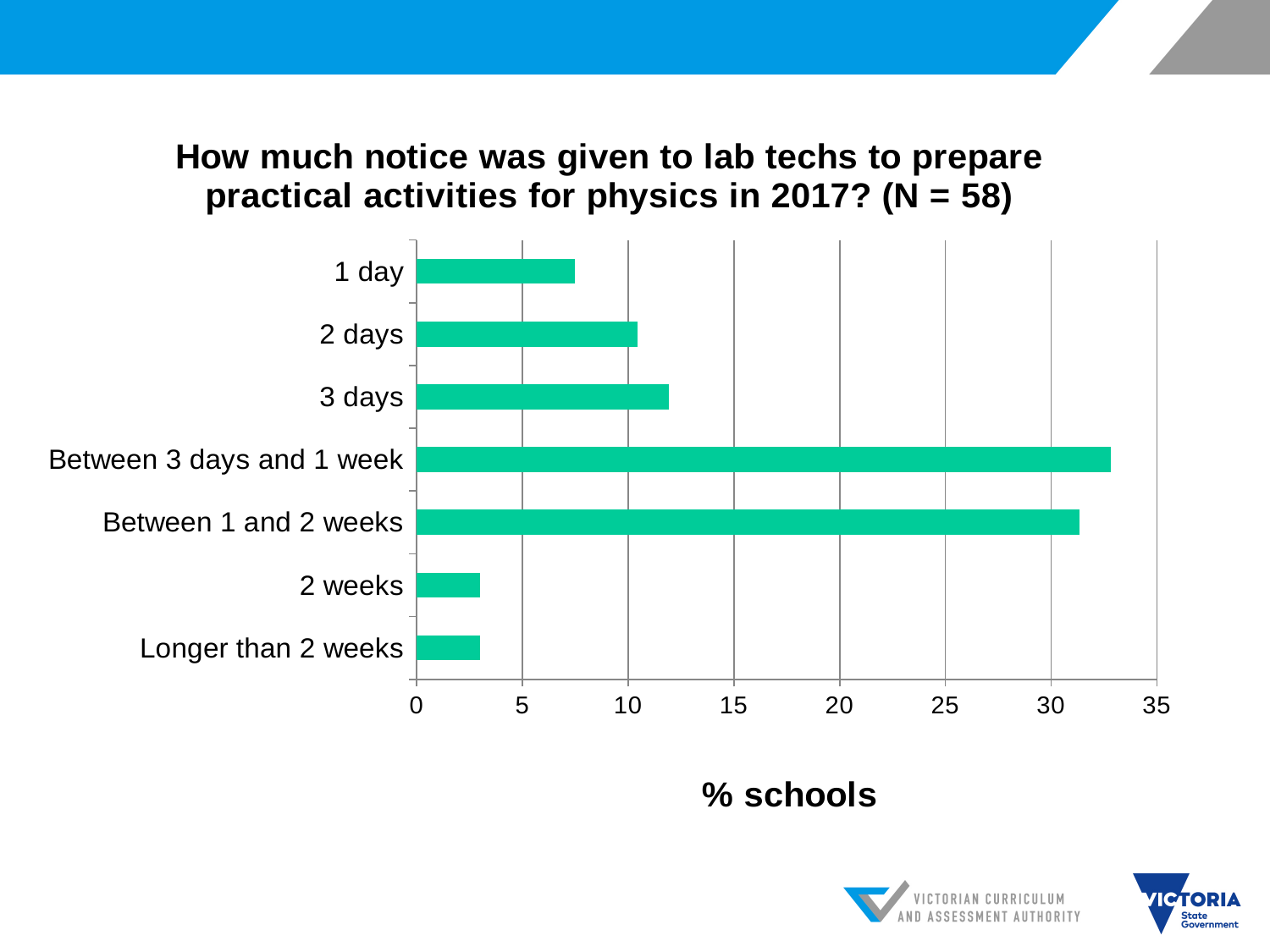
Is the value for Between 3 days and 1 week greater or less than 30? greater Is the value for Between 1 and 2 weeks greater or less than 30? greater What kind of chart is shown on the slide? bar chart What is the label on the horizontal axis of the chart? % schools What is the highest tick value shown on the horizontal axis? 35 Which is larger, the value for 1 day or the value for 2 days? 2 days Is the value for 2 weeks greater or less than 5? less How many categories are shown on the chart? 7 Which category has the highest value? Between 3 days and 1 week